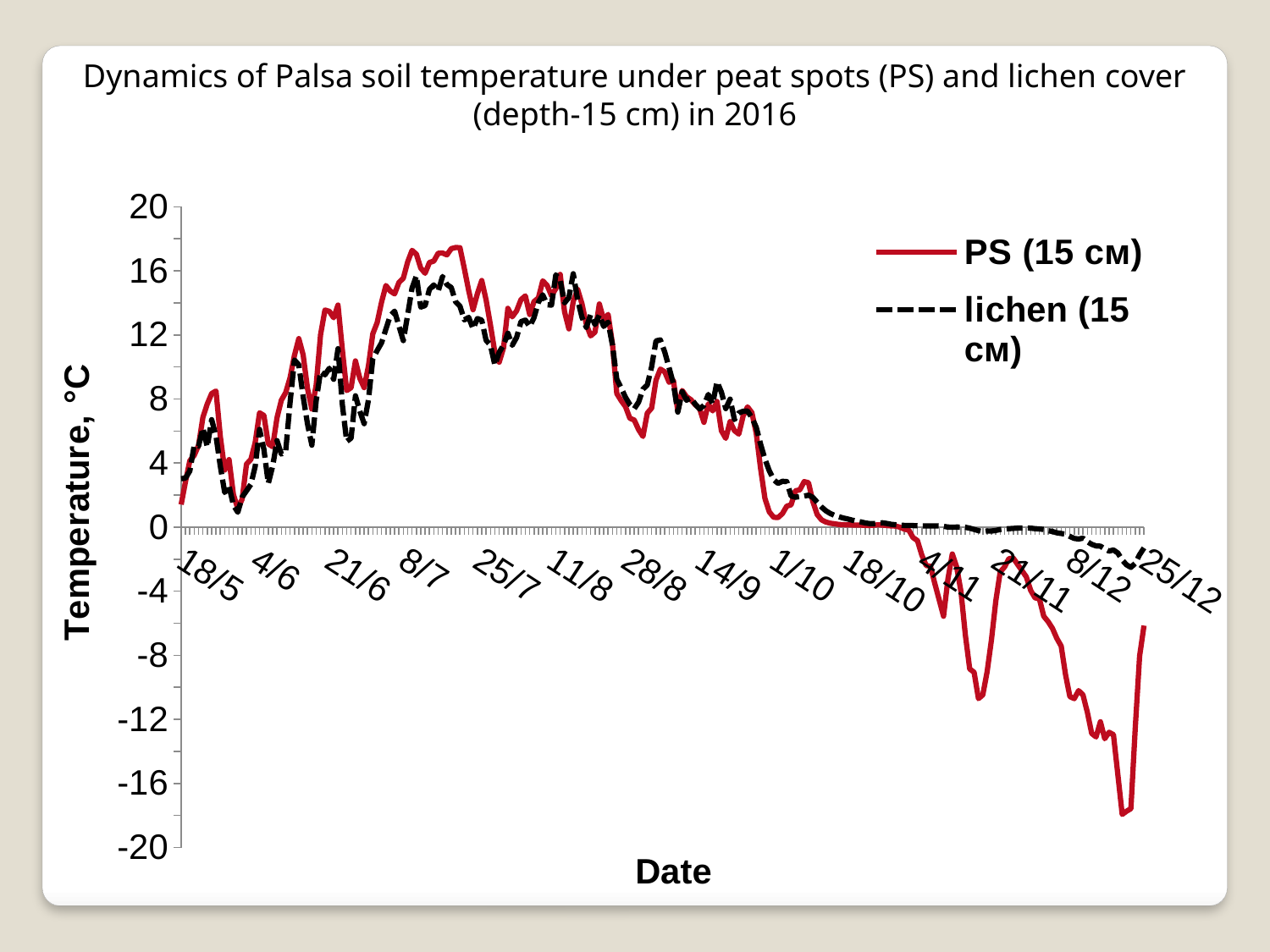
Which series reaches the lower temperature in December, PS (15 см) or lichen (15 см)? PS (15 см) Do the temperature values rise or fall from 8/7 to 8/12? fall Is the value of the lichen (15 см) series at 25/12 greater or less than -4? greater Is the value of the PS (15 см) series at 1/10 greater or less than 4? less Which series is higher around 8/7, PS (15 см) or lichen (15 см)? PS (15 см) Is the lowest value of the PS (15 см) series in December greater or less than -16? less How many series does the legend list? 2 What is the label of the y axis? Temperature, °C What kind of chart is shown on the slide? line chart What is the title of the chart? Dynamics of Palsa soil temperature under peat spots (PS) and lichen cover (depth-15 cm) in 2016 How many date labels are shown along the x axis? 14